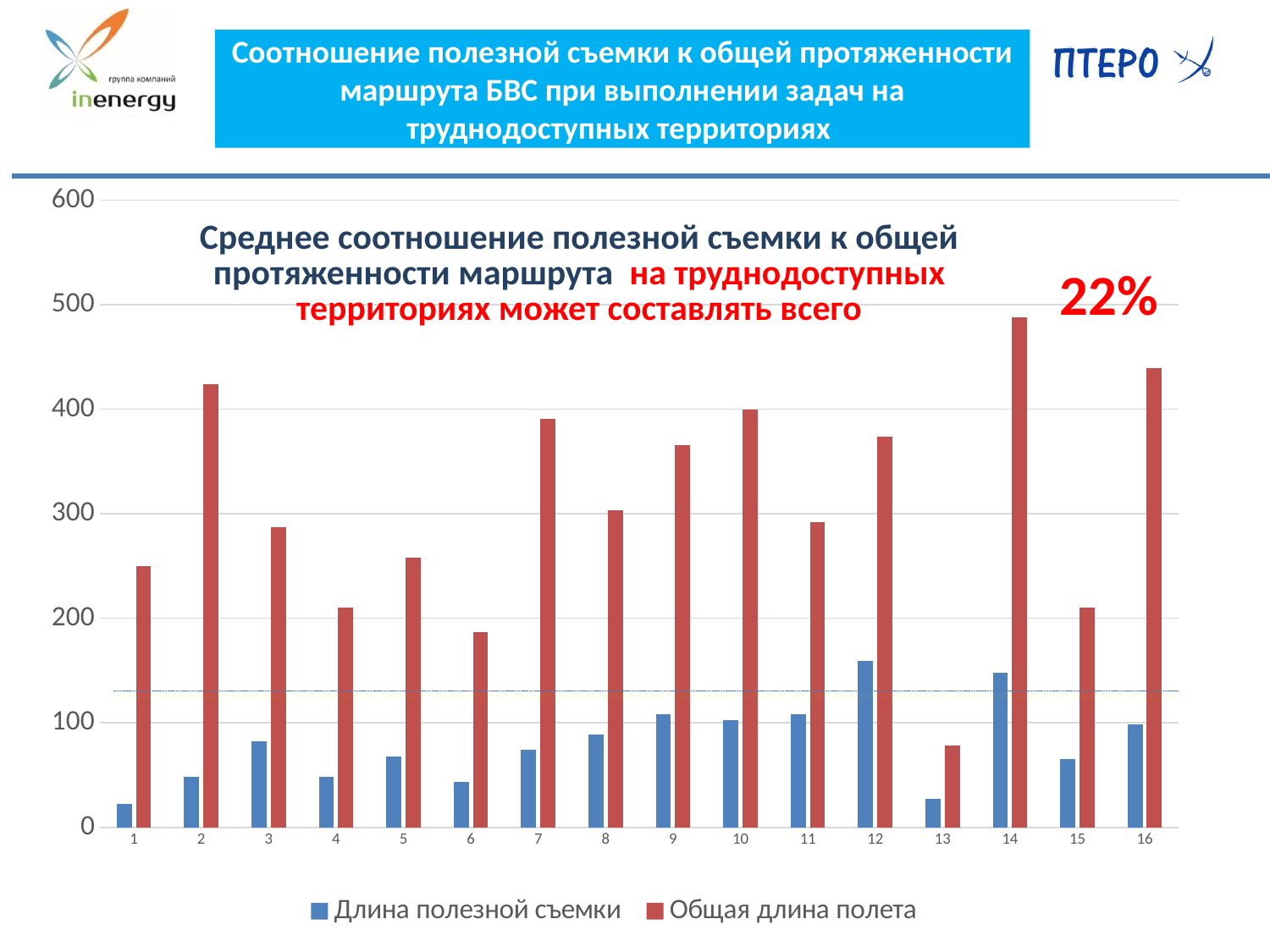
How many series does the chart legend list? 2 What kind of chart is shown on the slide? bar chart Is the value for Общая длина полета at category 13 greater or less than 100? less What average ratio percentage is highlighted in large red text on the chart? 22% Is the value for Длина полезной съемки at category 1 greater or less than 50? less Which is larger: Длина полезной съемки at category 9 or at category 3? category 9 How many categories are shown along the x axis of the chart? 16 Which category has the highest value for Длина полезной съемки? 12 Which is larger: Общая длина полета at category 7 or at category 8? category 7 Is the value for Общая длина полета at category 14 greater or less than 400? greater Which category has the highest value for Общая длина полета? 14 Which category has the lowest value for Общая длина полета? 13